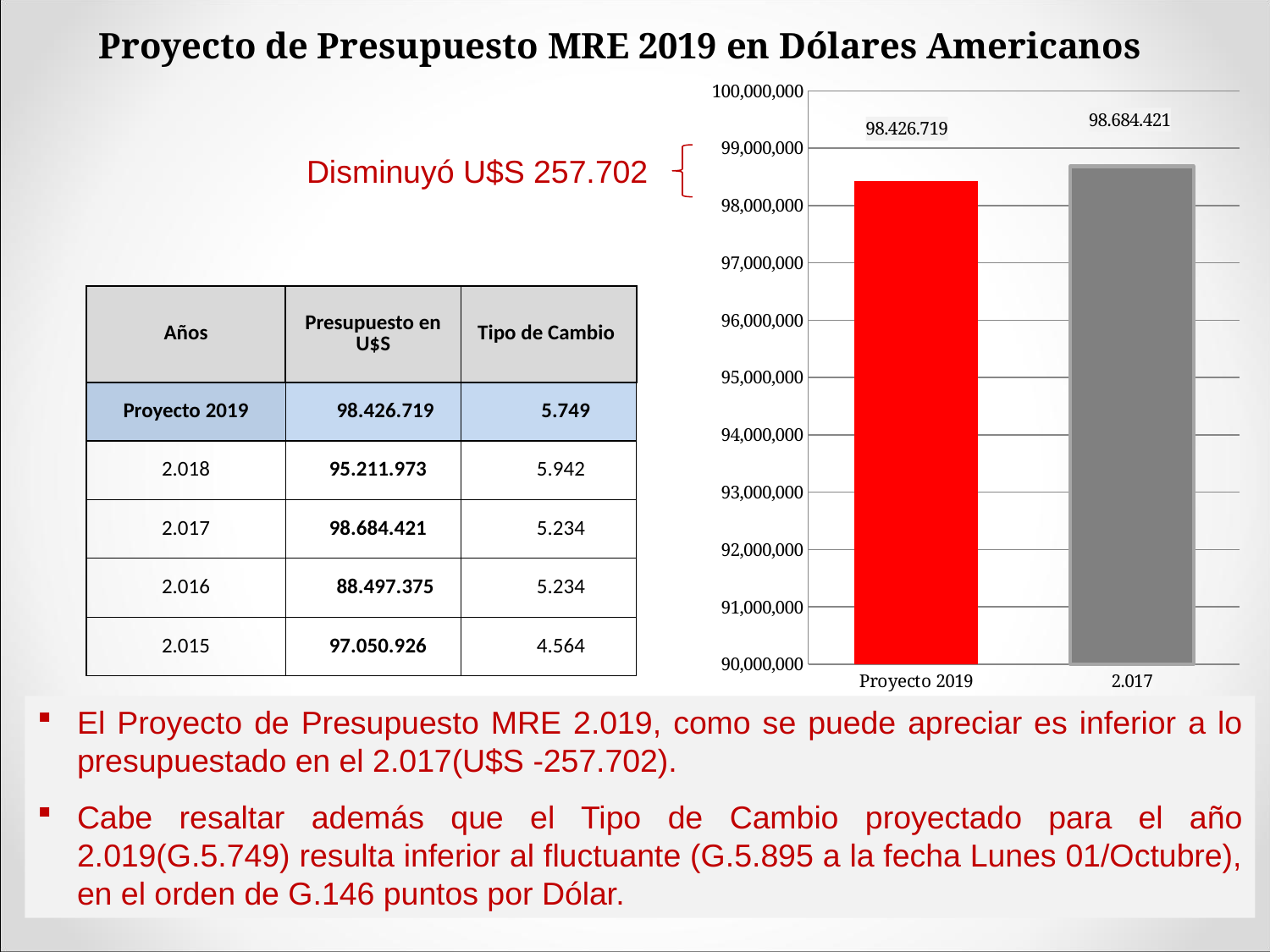
What is the lowest value shown on the chart's vertical axis? 90,000,000 What is the value shown for 2.017 in the bar chart? 98.684.421 Is the value for Proyecto 2019 greater or less than 98,000,000? greater How many bars are plotted in the chart? 2 What colour is the bar for Proyecto 2019? red What is the value shown for Proyecto 2019 in the bar chart? 98.426.719 Is the bar for Proyecto 2019 larger or smaller than the bar for 2.017? smaller What type of chart is shown on the slide? bar chart Which category has the higher bar in the chart? 2.017 What is the difference between the 2.017 value and the Proyecto 2019 value in the chart? 257.702 Is the value for 2.017 greater or less than 99,000,000? less Which category has the lower bar in the chart? Proyecto 2019